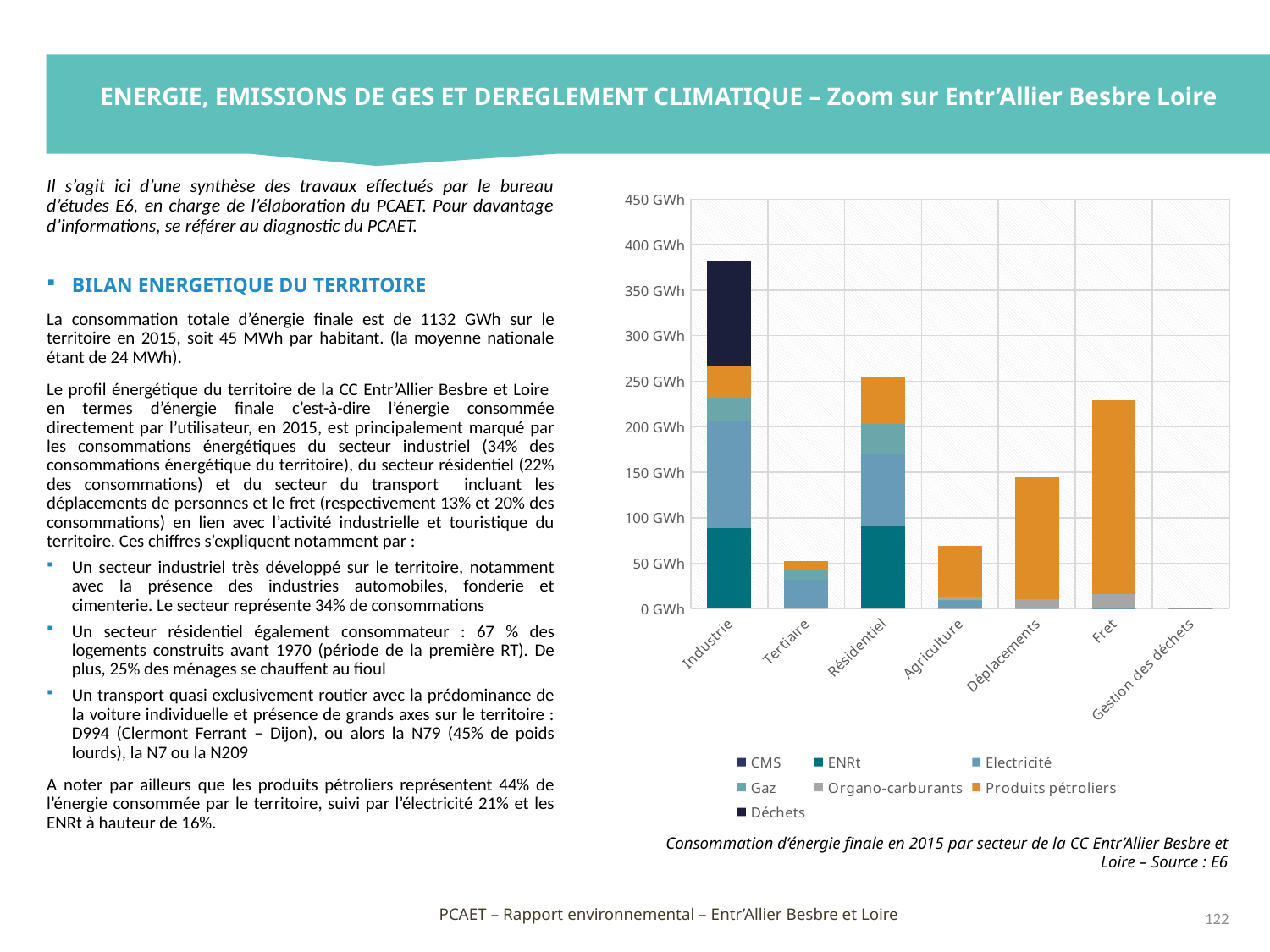
Is the total value for Industrie greater or less than 350 GWh? greater Which sector has a larger total consumption, Fret or Déplacements? Fret Which sector has the lowest total energy consumption in the chart? Gestion des déchets Is the total value for Tertiaire greater or less than 100 GWh? less Which sector has a larger total consumption, Industrie or Résidentiel? Industrie How many sectors (categories) are shown on the x axis of the chart? 7 Is the total value for Fret greater or less than 200 GWh? greater What kind of chart is shown on the slide? Stacked bar chart Which sector has the highest total energy consumption in the chart? Industrie Which legend entry is shown in orange in the chart? Produits pétroliers How many series does the chart legend list? 7